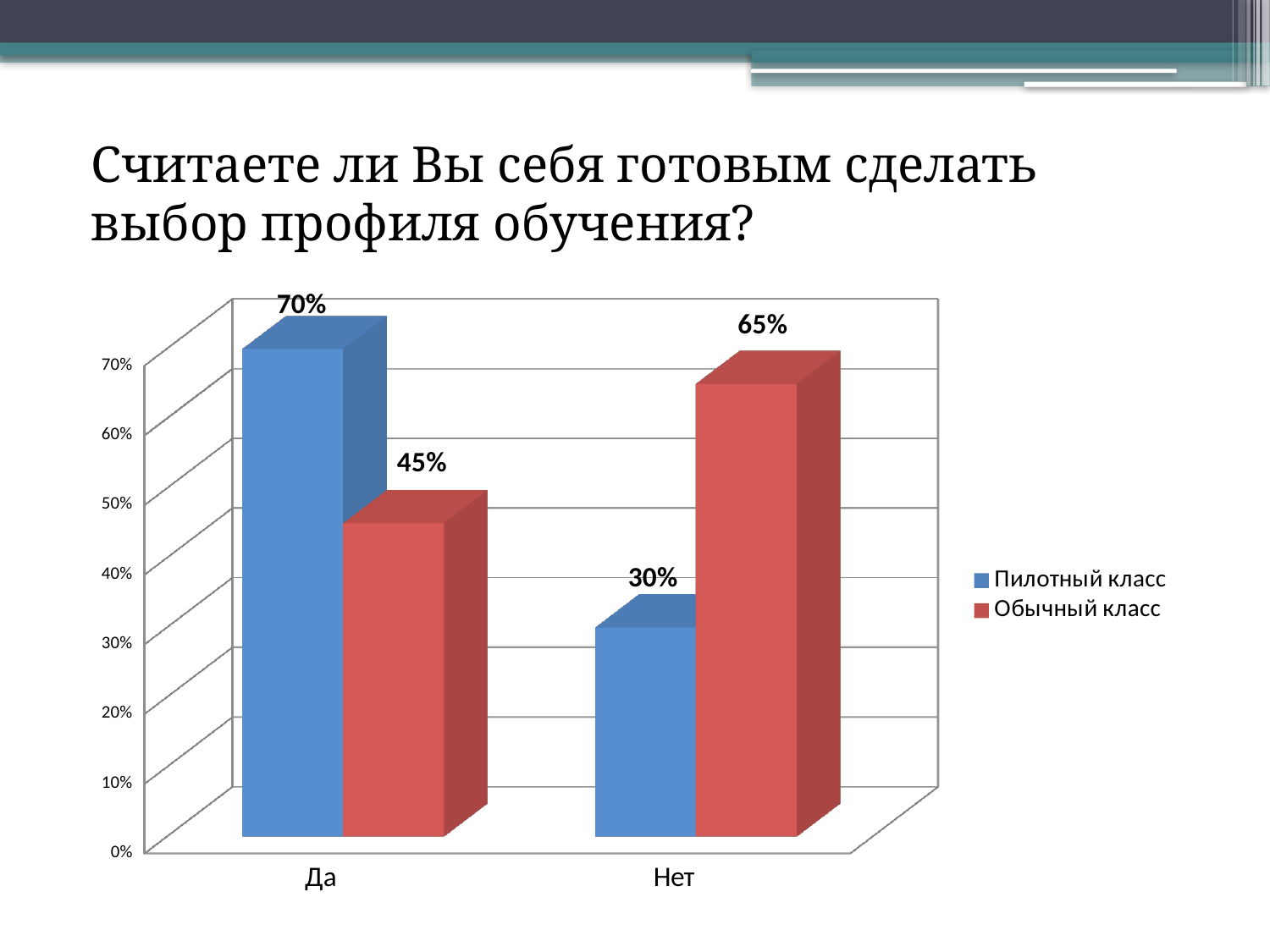
How many series does the legend list? 2 Which category has the highest value for Пилотный класс? Да What is the difference between Пилотный класс and Обычный класс in the Да category? 25% What is the value for Обычный класс in the Нет category? 65% What is the difference between Обычный класс and Пилотный класс in the Нет category? 35% What is the value for Пилотный класс in the Нет category? 30% Which is larger in the Нет category: Пилотный класс or Обычный класс? Обычный класс Which category has the lowest value for Обычный класс? Да What kind of chart is shown on the slide? Bar chart How many categories are shown on the x axis? 2 What is the value for Пилотный класс in the Да category? 70% What is the value for Обычный класс in the Да category? 45%